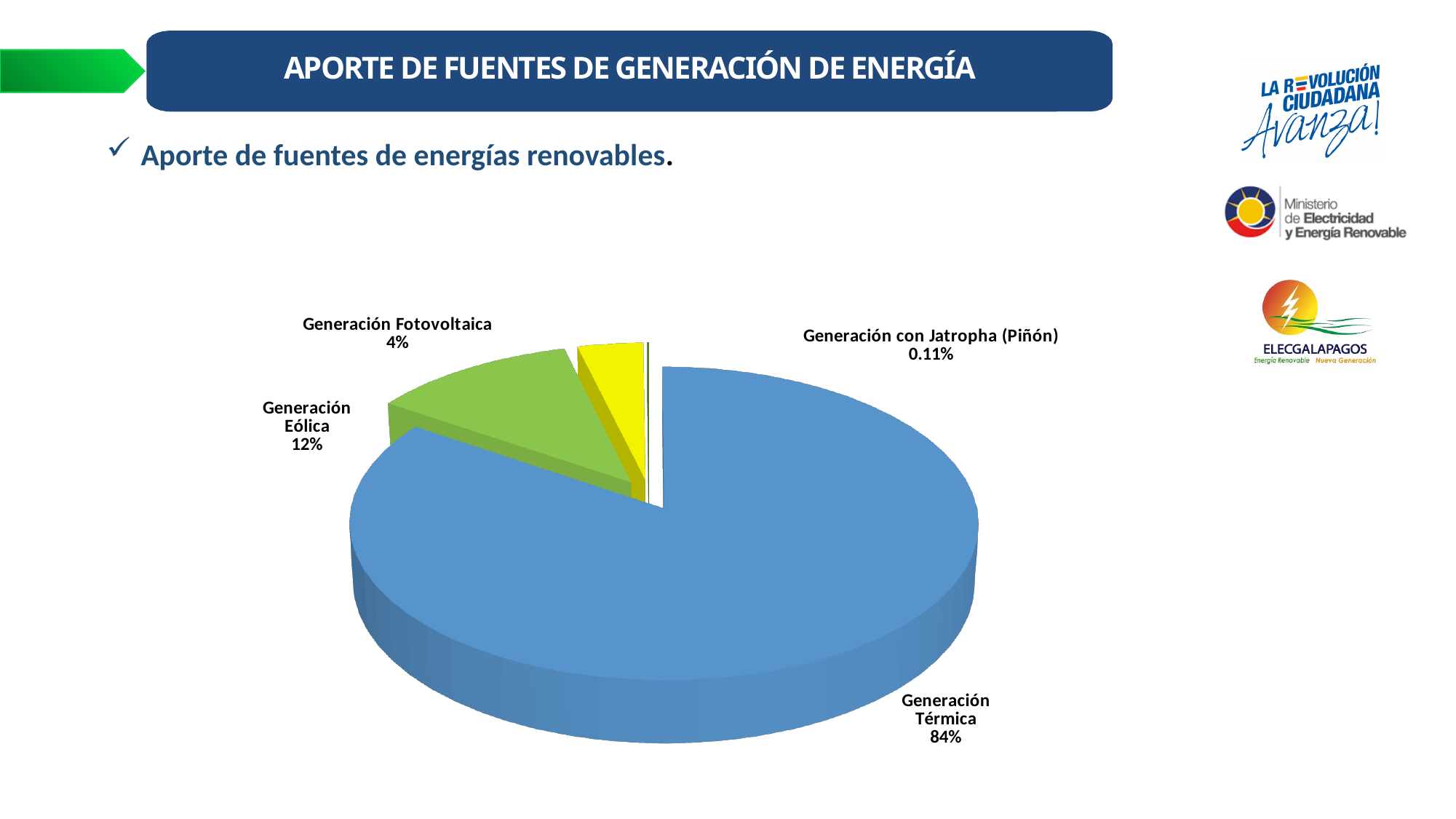
What share of the pie does Generación Fotovoltaica represent? 4% What is the difference in percentage points between Generación Térmica and Generación Eólica? 72 What share of the pie does Generación con Jatropha (Piñón) represent? 0.11% Which category has the smallest slice of the pie? Generación con Jatropha (Piñón) Which is larger, the share for Generación Eólica or Generación Fotovoltaica? Generación Eólica What is the difference in percentage points between Generación Eólica and Generación Fotovoltaica? 8 What share of the pie does Generación Térmica represent? 84% What colour is the slice for Generación Térmica? Blue How many categories are shown in the pie chart? 4 Which category has the largest slice of the pie? Generación Térmica What type of chart is shown on the slide? Pie chart